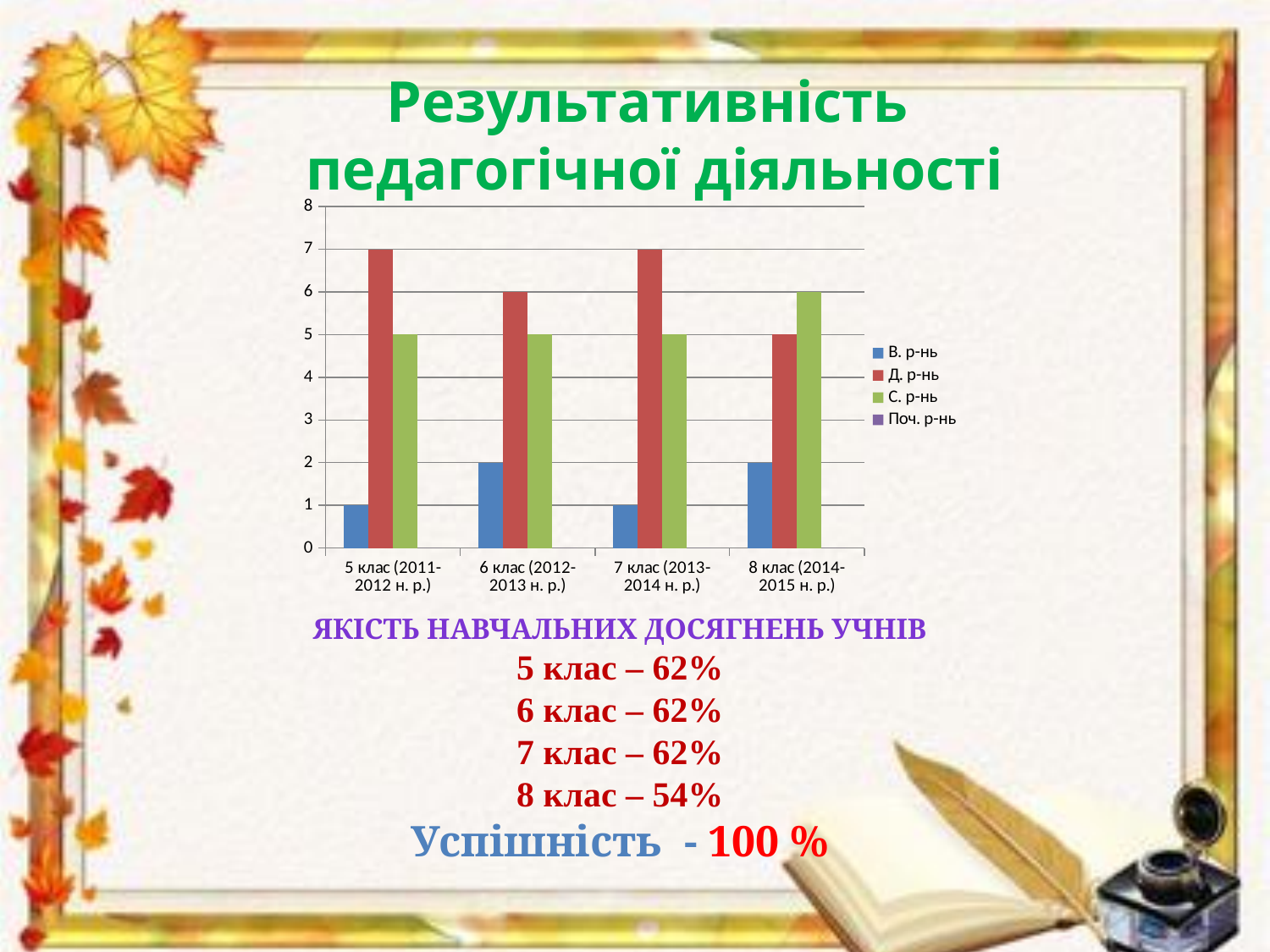
What is the value of Д. р-нь for 8 клас (2014-2015 н. р.)? 5 How many class categories are shown on the x axis of the chart? 4 Which class has the highest value for С. р-нь? 8 клас (2014-2015 н. р.) Which legend entry is shown in red? Д. р-нь Which class has the lowest value for Д. р-нь? 8 клас (2014-2015 н. р.) For 8 клас (2014-2015 н. р.), which is larger: Д. р-нь or С. р-нь? С. р-нь What kind of chart is shown on the slide? bar chart How many series does the chart legend list? 4 What is the value of В. р-нь for 6 клас (2012-2013 н. р.)? 2 What is the value of Д. р-нь for 5 клас (2011-2012 н. р.)? 7 What is the value of С. р-нь for 8 клас (2014-2015 н. р.)? 6 What is the difference between Д. р-нь and В. р-нь for 7 клас (2013-2014 н. р.)? 6